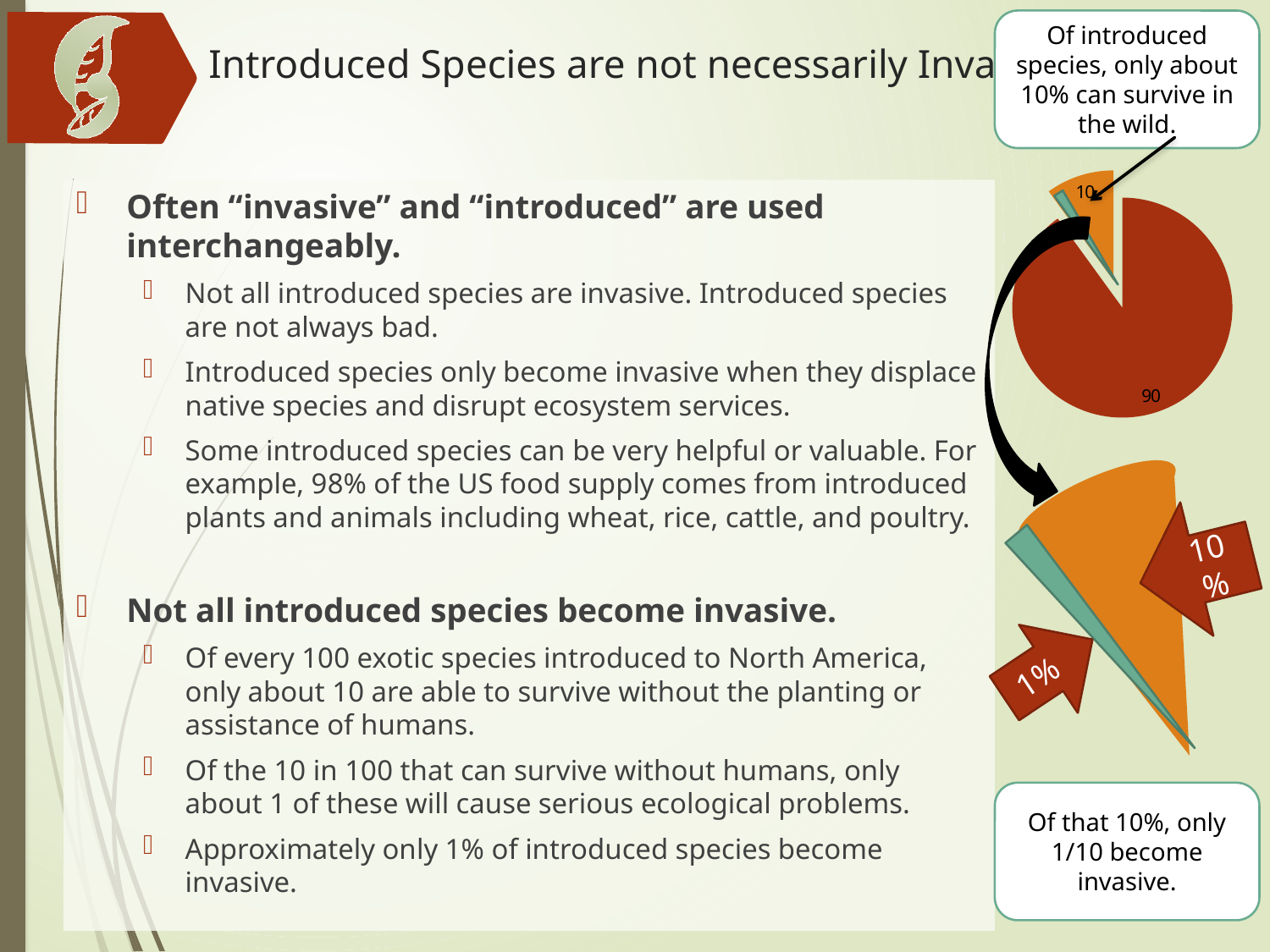
In the pie chart, what value is labelled on the largest slice? 90 What does the callout above the pie chart say? Of introduced species, only about 10% can survive in the wild. In the pie chart, what value is labelled on the dark red slice? 90 In the pie chart, which slice is larger: the dark red slice or the orange slice? the dark red slice What colour is the largest slice of the pie chart? dark red In the pie chart, what value is labelled on the orange slice? 10 In the pie chart, is the value of the orange slice greater or less than 50? less In the pie chart, what is the difference between the slice labelled 90 and the slice labelled 10? 80 What kind of chart is shown on the right side of the slide? pie chart